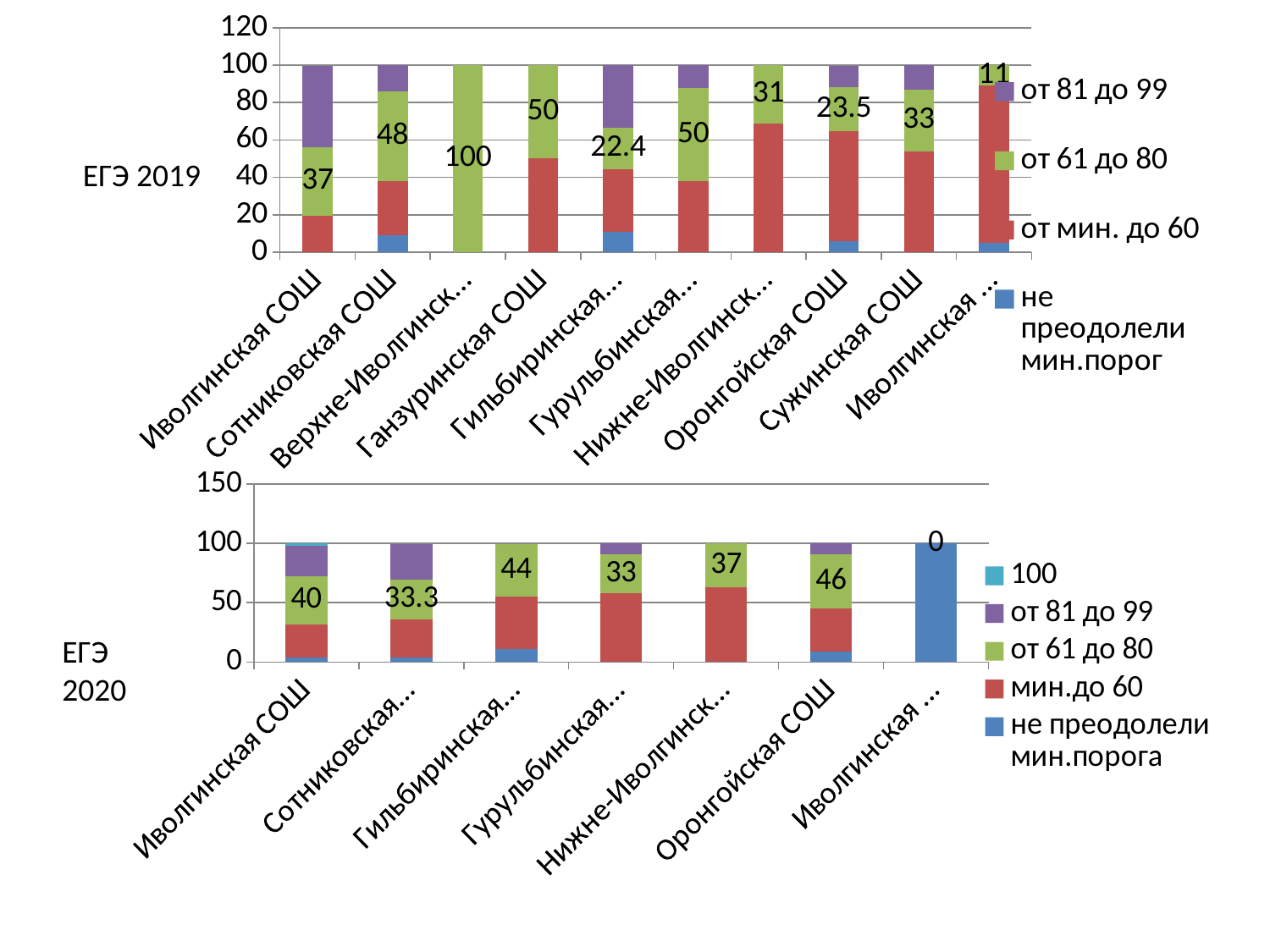
In the ЕГЭ 2019 chart, what is the labelled value of the 'от 61 до 80' segment for Сотниковская СОШ? 48 In the ЕГЭ 2020 chart, what is the labelled value for Сотниковская? 33.3 How many series does the legend of the ЕГЭ 2019 chart list? 4 How many series does the legend of the ЕГЭ 2020 chart list? 5 In the ЕГЭ 2020 chart, which school has the highest labelled 'от 61 до 80' value? Оронгойская СОШ In the ЕГЭ 2020 chart, is the labelled value for Гильбиринская larger than the labelled value for Гурульбинская? Yes In the ЕГЭ 2019 chart, which school has the highest labelled 'от 61 до 80' value? Верхне-Иволгинская In the ЕГЭ 2019 chart, what is the labelled value for Оронгойская СОШ? 23.5 In the ЕГЭ 2019 chart, what is the difference between the labelled values for Ганзуринская СОШ and Нижне-Иволгинская? 19 How many schools (categories) are shown in the ЕГЭ 2019 chart? 10 What type of chart is the ЕГЭ 2020 chart? Stacked bar chart In the ЕГЭ 2019 chart, what is the labelled value of the 'от 61 до 80' segment for Иволгинская СОШ? 37